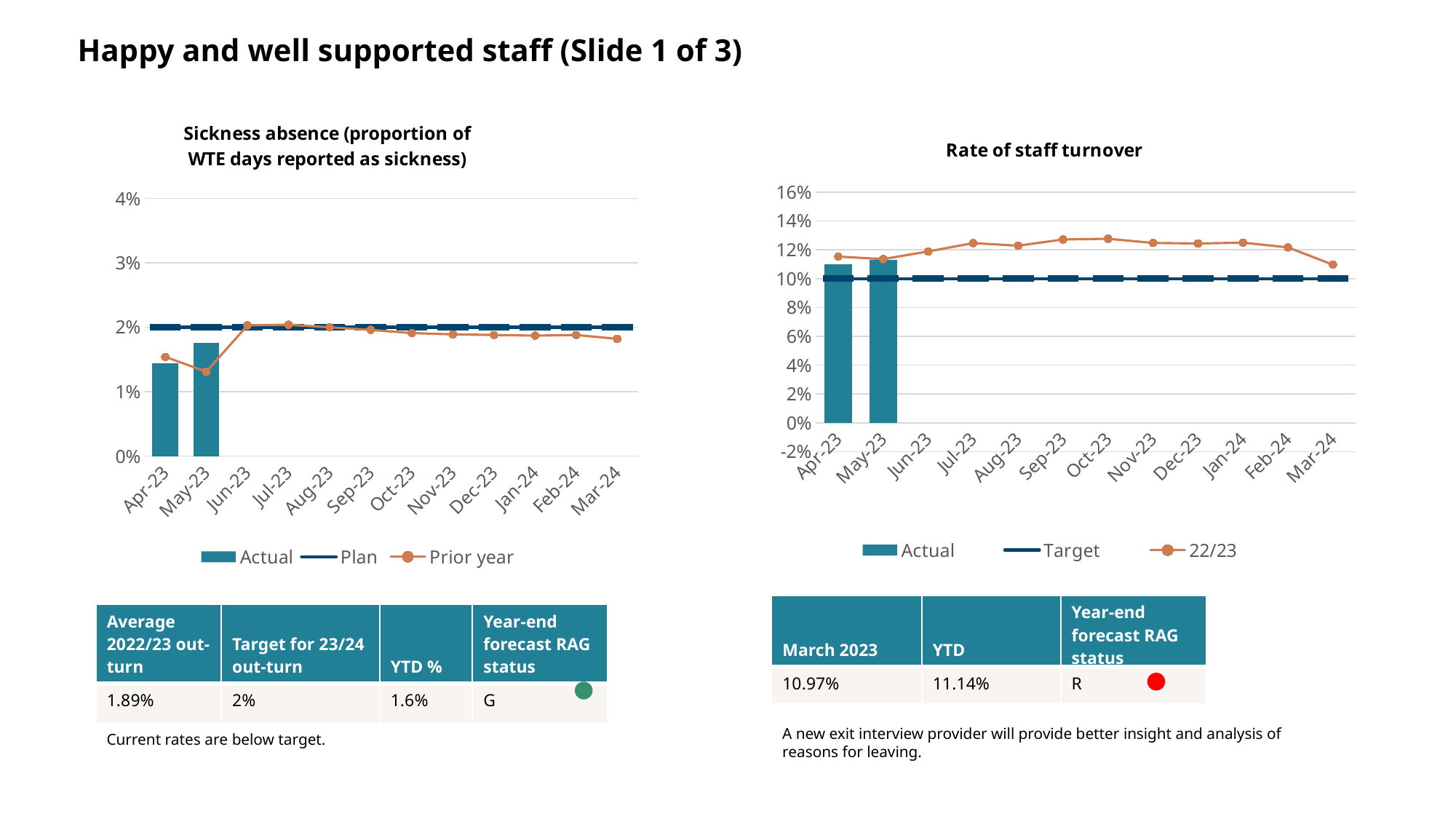
How many series does the legend of the 'Rate of staff turnover' chart list? 3 In the 'Sickness absence' chart, what value does the Plan line sit at? 2% In the 'Sickness absence' chart, is the Actual value for Apr-23 greater or less than 2%? less What are the legend entries of the 'Sickness absence' chart? Actual, Plan, Prior year How many months are shown on the x axis of the 'Rate of staff turnover' chart? 12 In the 'Sickness absence' chart, which month has the lowest Prior year value? May-23 In the 'Rate of staff turnover' chart, what value does the Target line sit at? 10% In the 'Sickness absence' chart, does the Prior year line rise or fall from Jul-23 to Mar-24? fall What kind of chart is the 'Sickness absence (proportion of WTE days reported as sickness)' chart? A combined bar and line chart In the 'Rate of staff turnover' chart, is the 22/23 value for Sep-23 greater or less than 12%? greater In the 'Sickness absence' chart, which month has the larger Actual bar, Apr-23 or May-23? May-23 In the 'Rate of staff turnover' chart, is the Actual value for Apr-23 greater or less than 10%? greater